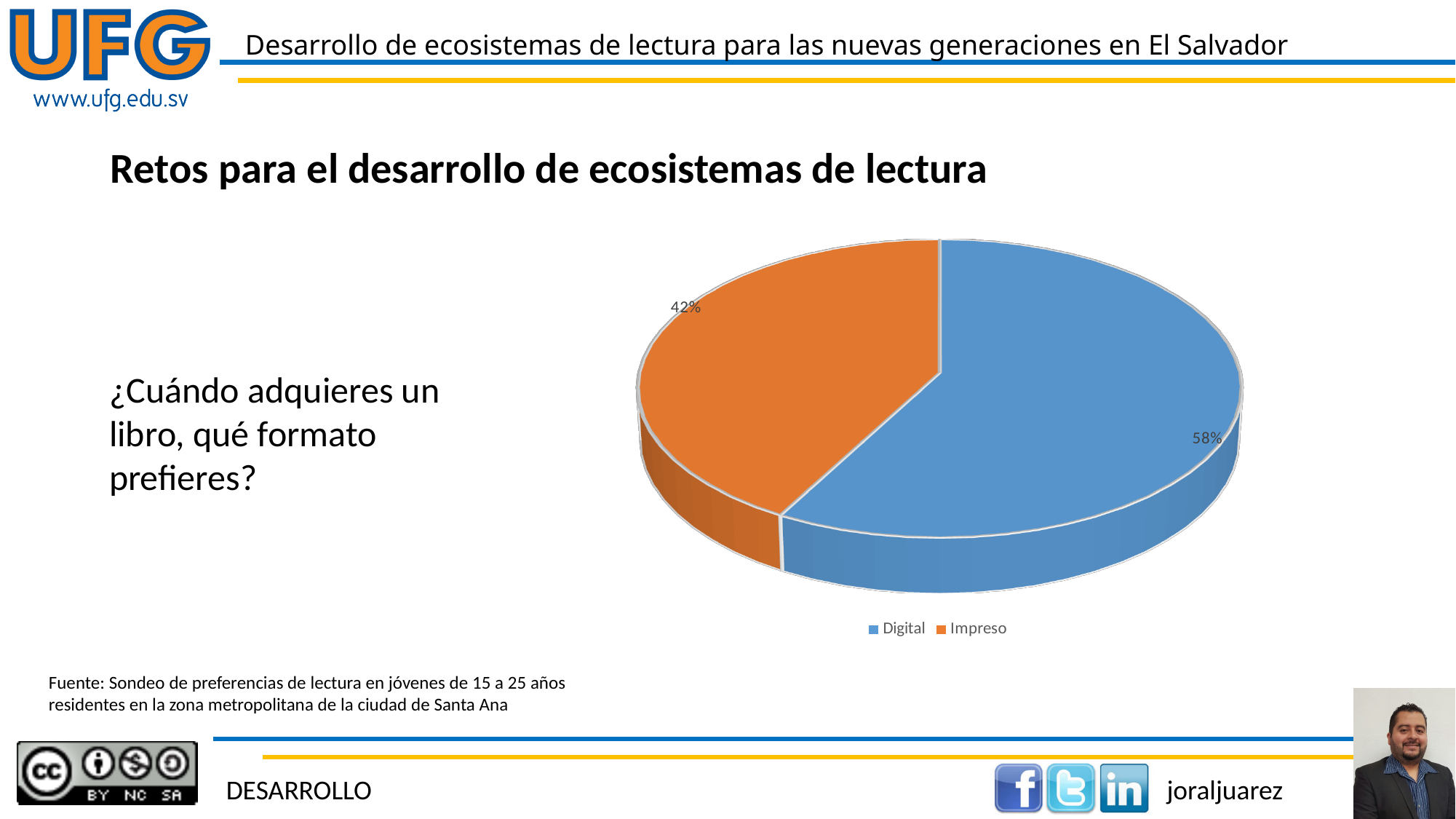
What colour is the Digital slice? blue Which category has the largest slice of the pie? Digital What share of the pie does Impreso have? 42% What is the difference in percentage points between Digital and Impreso? 16 Which is larger, the Digital slice or the Impreso slice? Digital How many entries does the legend list? 2 What kind of chart is shown on the slide? pie chart How many slices does the pie chart have? 2 What colour is the Impreso slice? orange What share of the pie does Digital have? 58% Which category has the smallest slice of the pie? Impreso